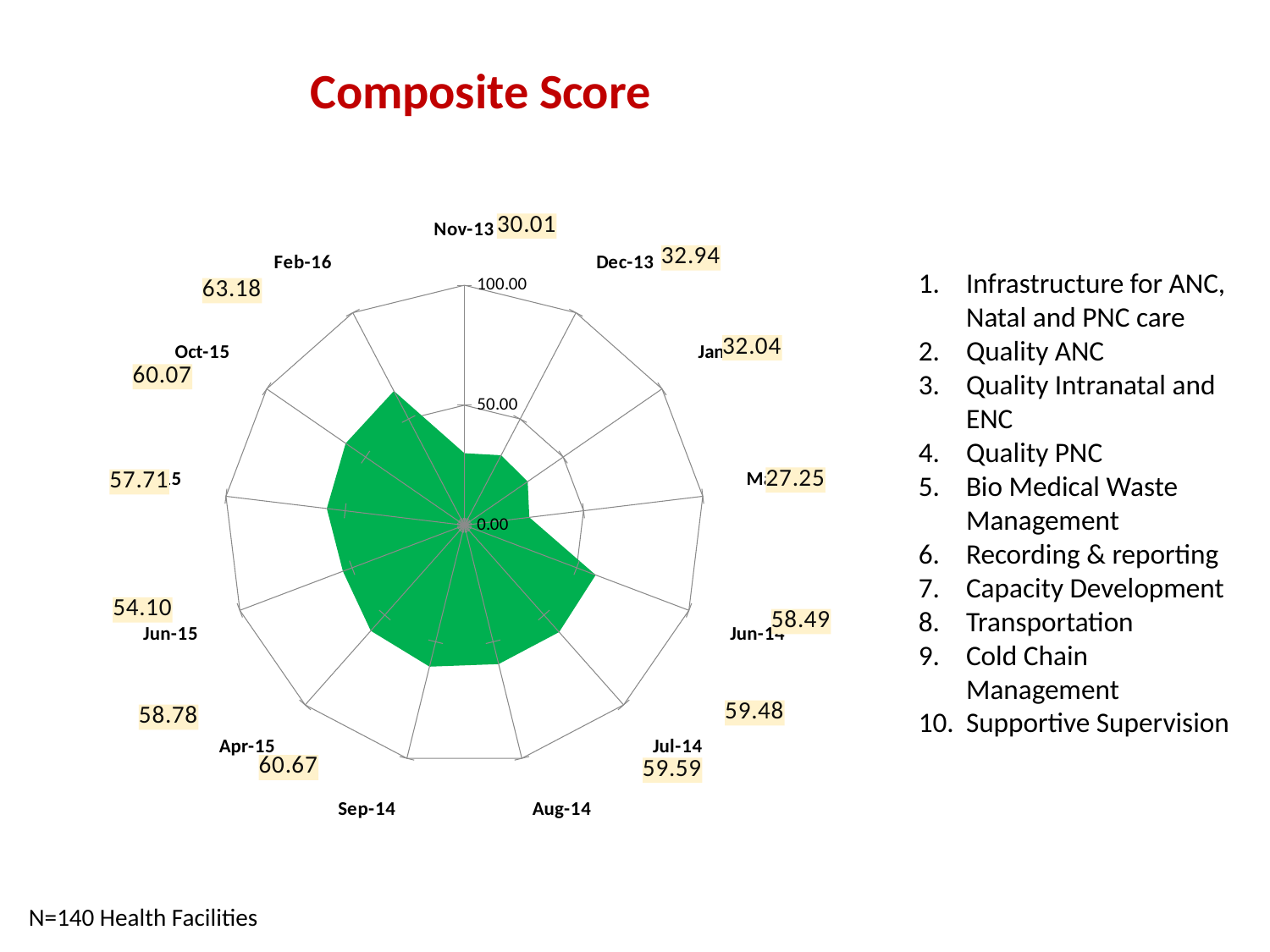
What is the difference between the composite scores for Feb-16 and Nov-13? 33.17 What is the composite score for Nov-13? 30.01 Is the composite score for Nov-13 greater or less than 50.00? less Which has the larger composite score, Apr-15 or Jun-15? Apr-15 What is the composite score for Feb-16? 63.18 What type of chart is shown on the slide? Radar chart What is the composite score for Oct-15? 60.07 What is the composite score for Jun-15? 54.10 What is the composite score for Apr-15? 58.78 What is the title of the chart? Composite Score Which labelled month has the highest composite score? Feb-16 What is the composite score for Dec-13? 32.94